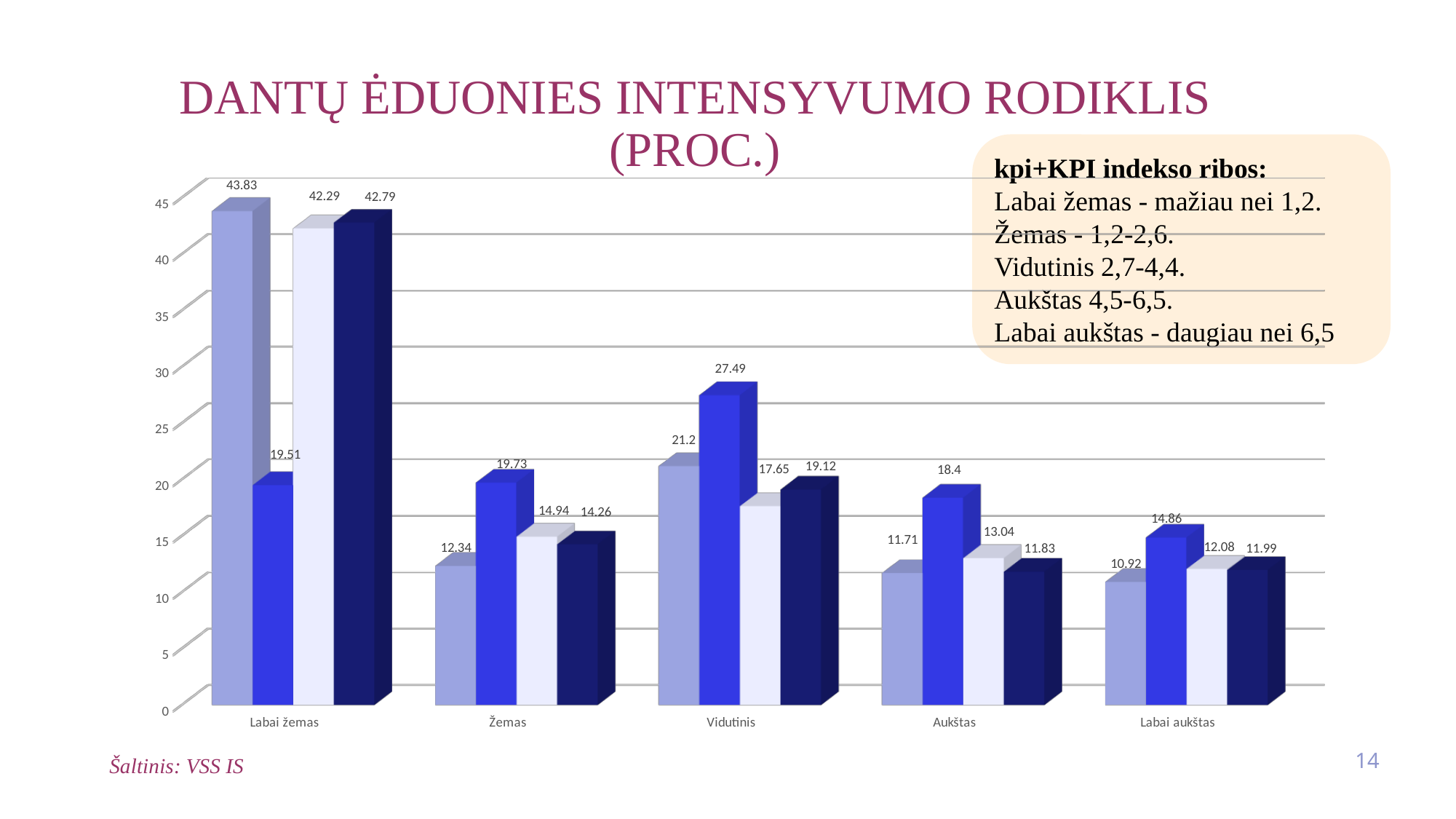
What type of chart is shown on the slide? bar chart What is the value of the first (light periwinkle) bar for Labai žemas? 43.83 Which is larger for Aukštas: the bright blue bar or the dark navy bar? the bright blue bar How many bars are plotted for each category in the chart? 4 What is the value of the dark navy bar for Labai aukštas? 11.99 What is the title of the chart on the slide? DANTŲ ĖDUONIES INTENSYVUMO RODIKLIS (PROC.) Which category has the lowest value for the first (light periwinkle) bar? Labai aukštas What is the value of the bright blue bar for Vidutinis? 27.49 Which category has the highest value for the bright blue bar? Vidutinis Is the value of the first (light periwinkle) bar for Vidutinis greater or less than 20? greater What is the difference between the first (light periwinkle) bar and the bright blue bar for Labai žemas? 24.32 How many categories are shown on the x axis of the chart? 5